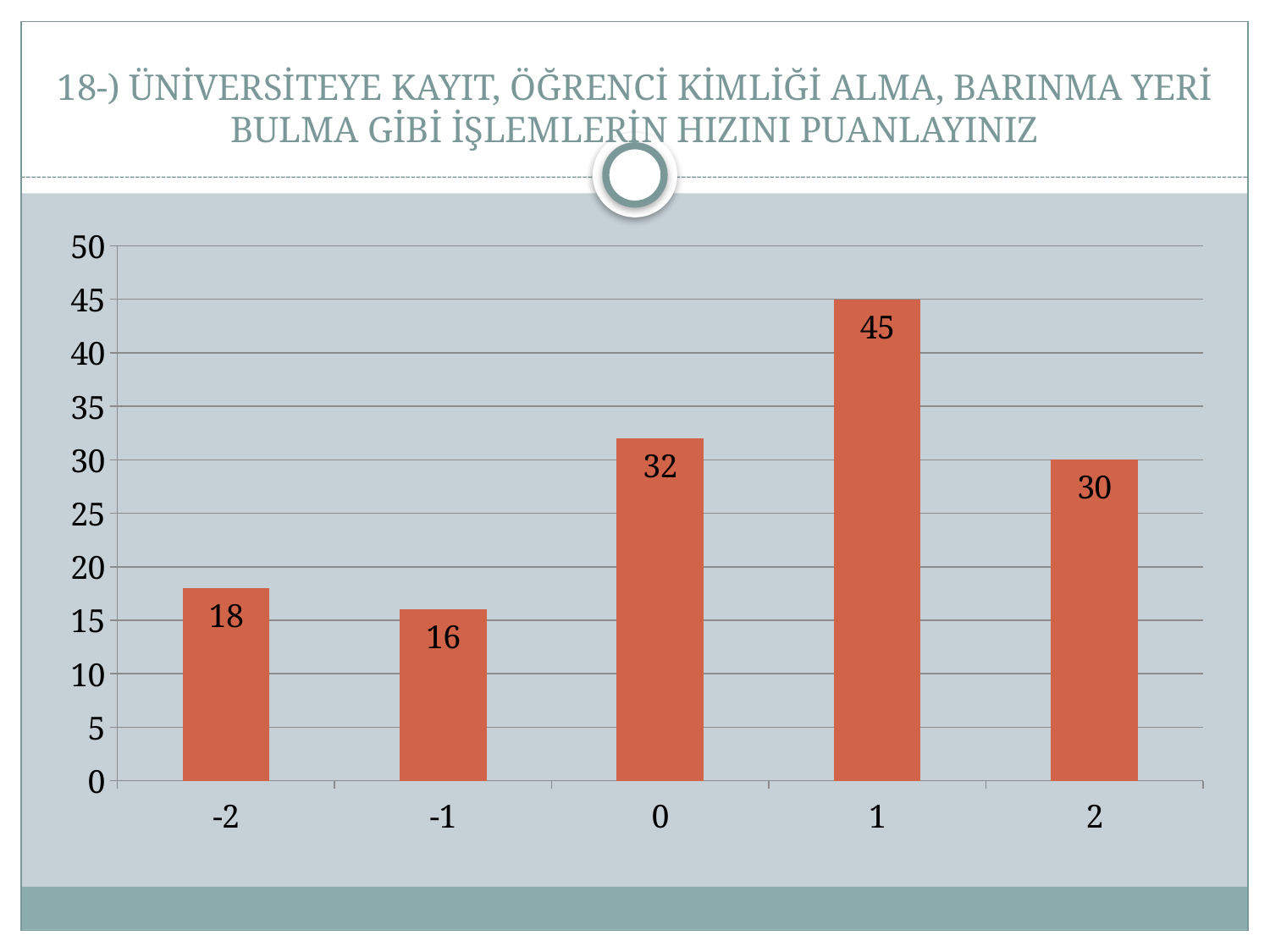
How many categories are shown on the x axis? 5 Is the value for category 1 greater or less than 40? greater What is the value for category 0? 32 What is the value for category -2? 18 What is the value for category 2? 30 What kind of chart is shown on the slide? bar chart What is the difference between the values for category 1 and category 0? 13 What is the value for category 1? 45 Which category has the lowest value? -1 Which category has the highest value? 1 What is the difference between the values for category -2 and category -1? 2 Which is larger, the value for category 0 or the value for category 2? 0